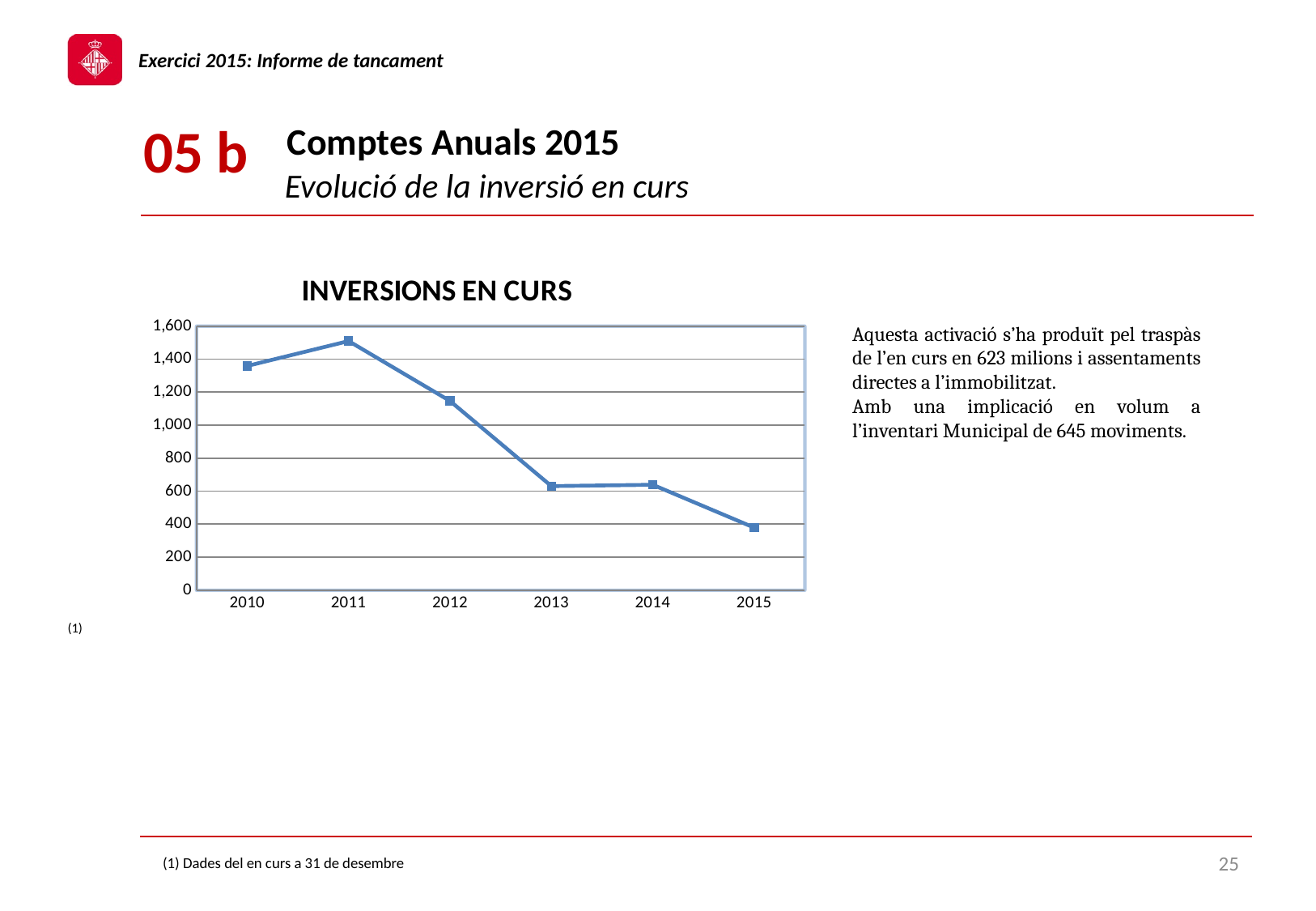
Which year has the larger value, 2010 or 2014? 2010 Is the value for 2011 greater or less than 1,400? greater What is the title of the chart? INVERSIONS EN CURS How many years are plotted on the x axis of the chart? 6 Which year has the highest value in the chart? 2011 Is the value for 2012 greater or less than 1,000? greater Which year has the lowest value in the chart? 2015 What kind of chart is shown on the slide? line chart Is the value for 2013 greater or less than 800? less Do the values rise or fall from 2011 to 2015? fall Which year has the larger value, 2011 or 2012? 2011